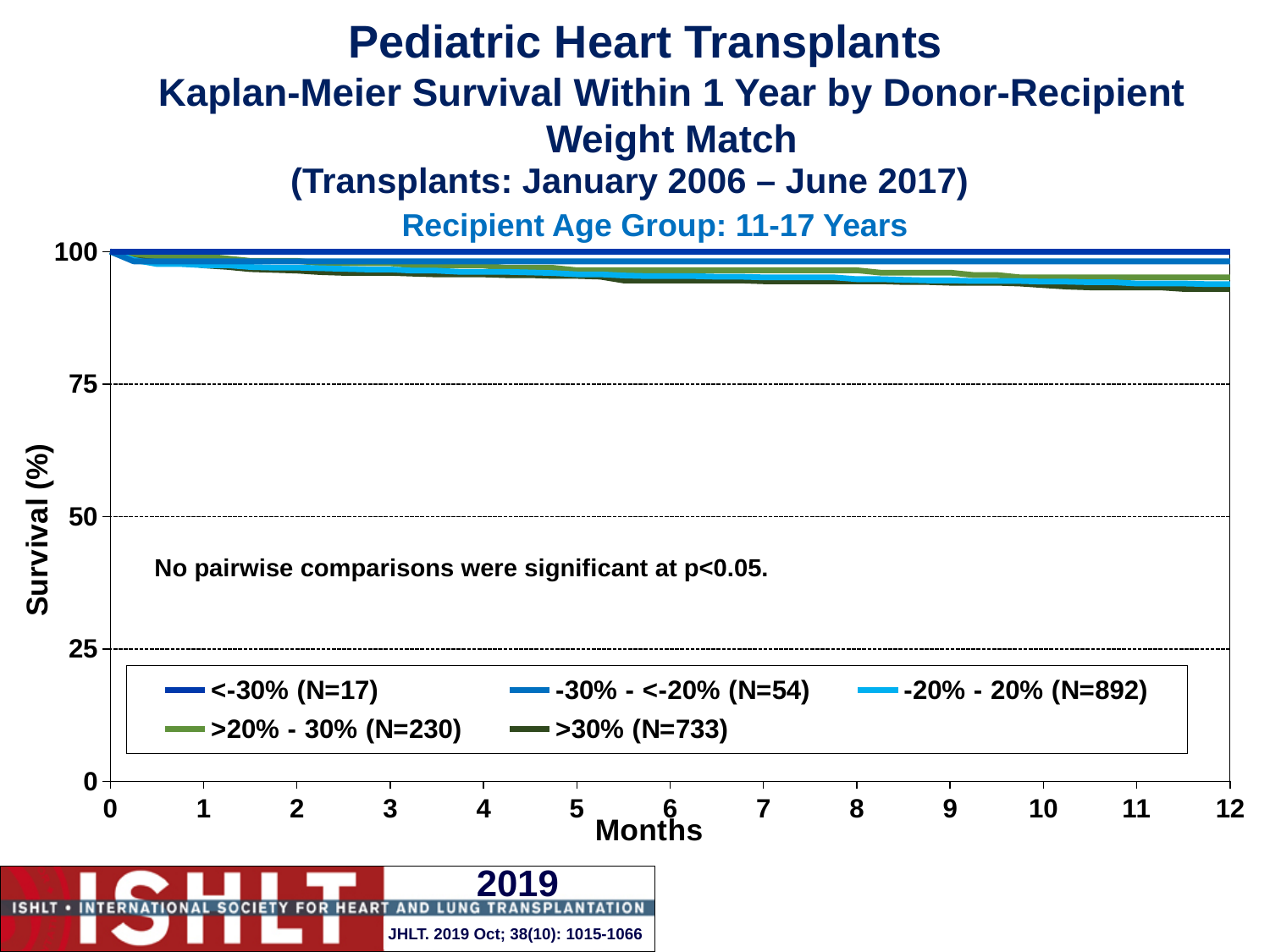
Is the survival value for the >30% group at 12 months greater or less than 75? greater How many month tick marks are labelled on the x axis? 13 Is the survival for the <-30% group at 12 months greater or less than the survival for the >30% group at 12 months? greater What is the highest value shown on the y axis? 100 Is the survival value for the -20% - 20% group at 6 months greater or less than 75? greater How many series does the legend list? 5 What kind of chart is shown on the slide? line chart Do the survival curves rise or fall as months increase? fall What is the label of the y axis? Survival (%) What is the N for the >30% weight match group shown in the legend? 733 Which weight match group has the highest survival at 12 months? <-30% (N=17)